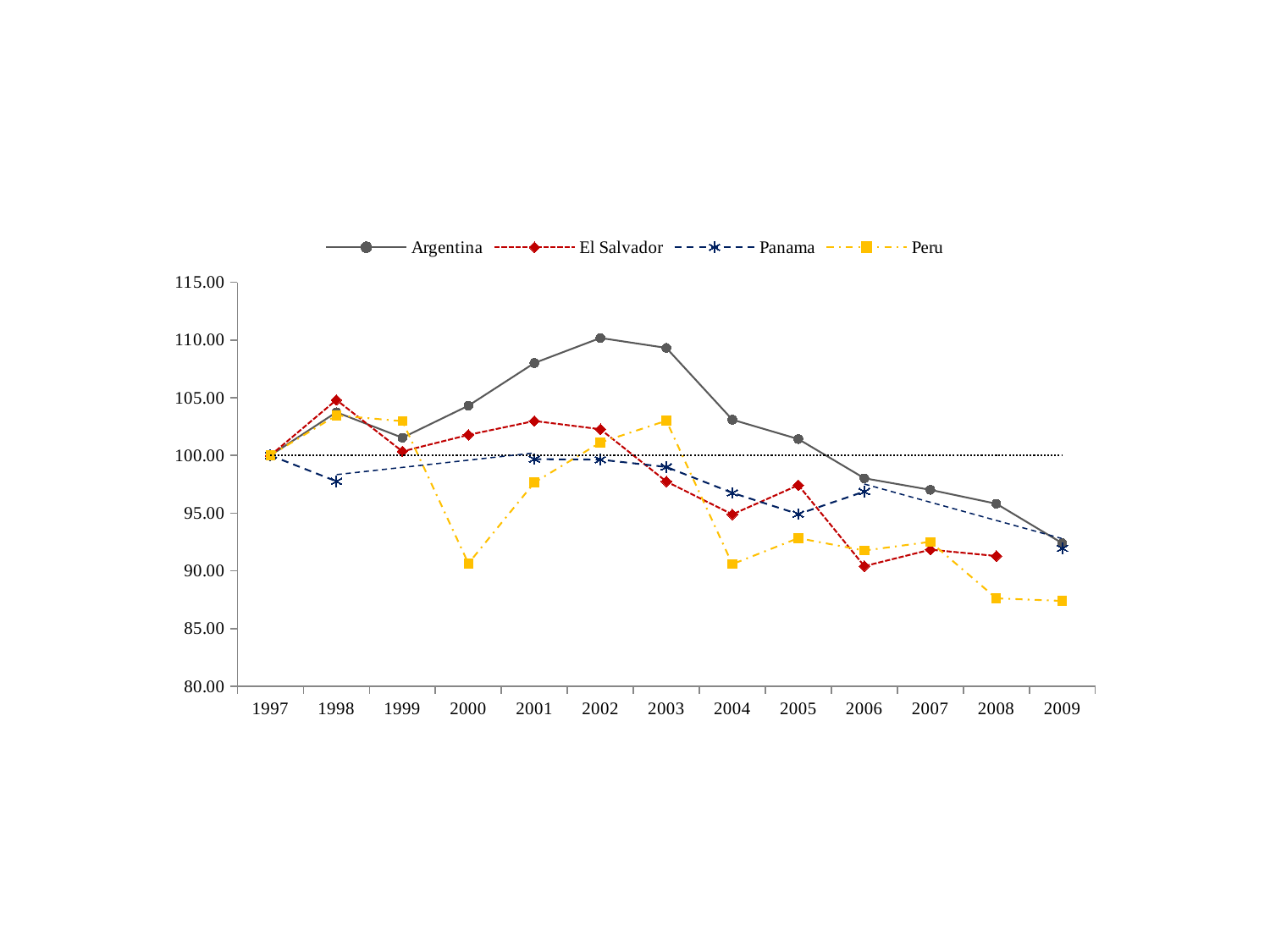
Which series has the lowest value in 2009? Peru Is the value for Argentina in 2002 greater or less than 105.00? greater How many series does the legend list? 4 In which year does Panama reach its lowest value? 2009 Does the Argentina series rise or fall from 2002 to 2009? fall At what value is the dotted horizontal reference line drawn? 100.00 What is the value for Argentina in 1997? 100.00 How many years are shown on the x axis? 13 In which year does Argentina reach its highest value? 2002 In 2004, which is larger: the value for Panama or the value for Peru? Panama Is the value for Peru in 2000 greater or less than 95.00? less What kind of chart is shown on the slide? line chart